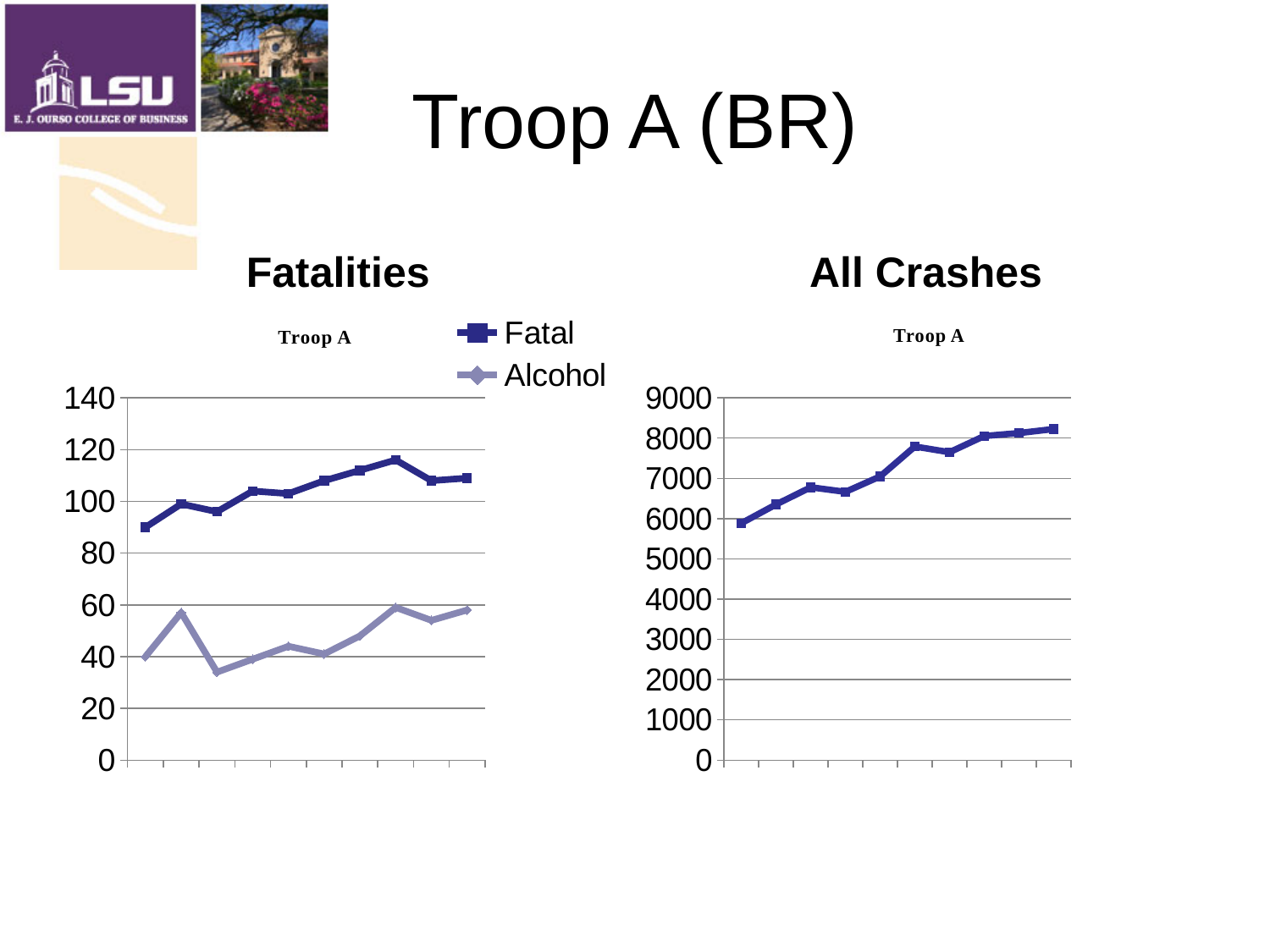
What are the two series named in the legend of the Fatalities chart? Fatal and Alcohol Do the values in the All Crashes chart generally rise or fall from left to right? rise In the All Crashes chart, is the last point greater or less than 8000? greater How many data points are plotted on the All Crashes chart? 10 In the Fatalities chart, is the first point of the Fatal series greater or less than 80? greater What is the title printed above the plot area of the All Crashes chart? Troop A In the Fatalities chart, which series has higher values throughout, Fatal or Alcohol? Fatal In the Fatalities chart, is the highest point of the Alcohol series greater or less than 80? less How many series does the legend of the Fatalities chart list? 2 What kind of chart is the Fatalities chart on the left? line chart What kind of chart is the All Crashes chart on the right? line chart